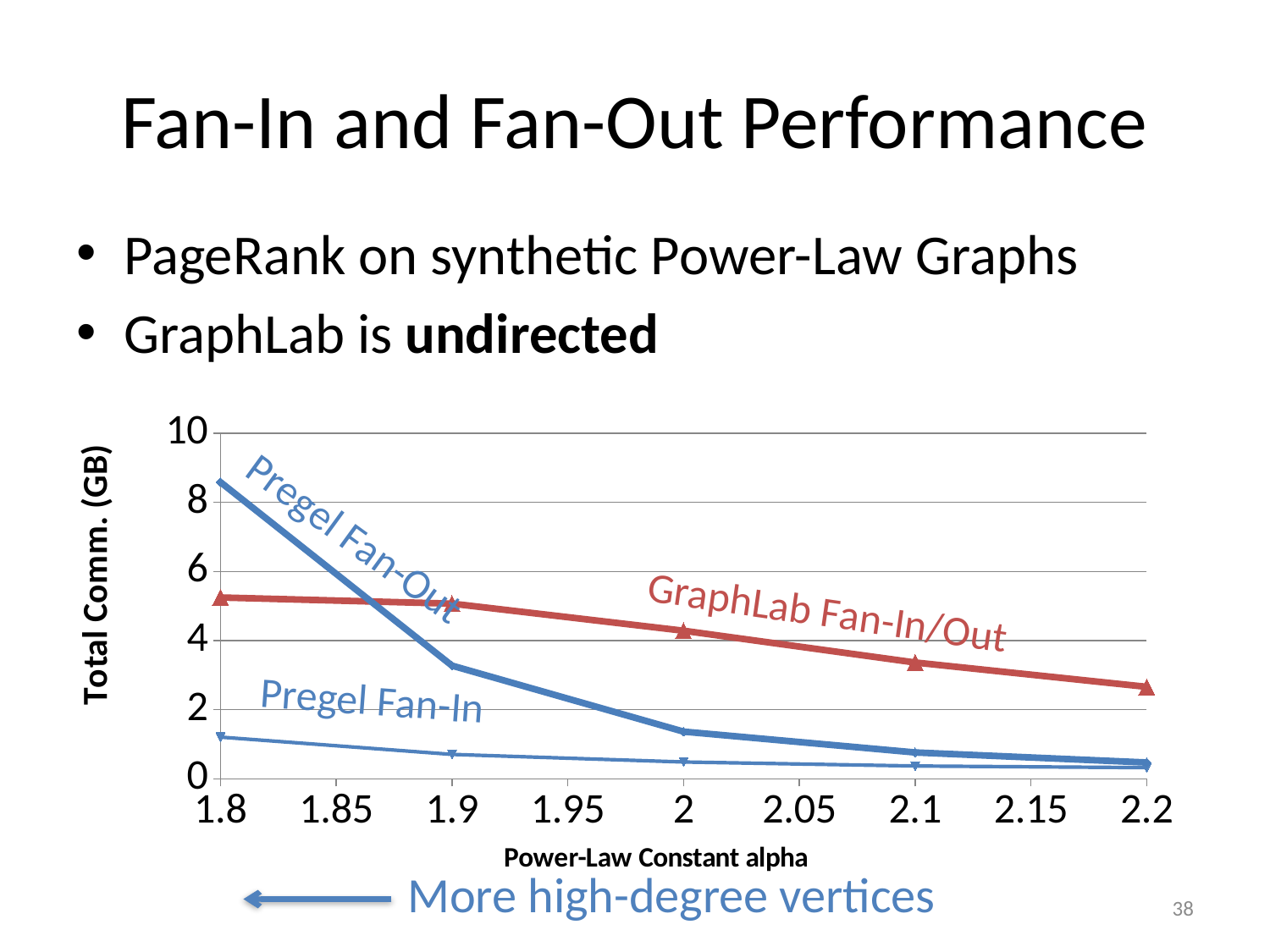
Which series has the highest value at alpha = 1.8? Pregel Fan-Out What kind of chart is shown on the slide? line chart Is the value for GraphLab Fan-In/Out at alpha = 1.8 greater or less than 6? less At alpha = 2, which is larger: GraphLab Fan-In/Out or Pregel Fan-Out? GraphLab Fan-In/Out What is the title of the x axis of the chart? Power-Law Constant alpha Which series has the lowest value at alpha = 1.8? Pregel Fan-In What is the title of the y axis of the chart? Total Comm. (GB) Does the Pregel Fan-Out series rise or fall as alpha increases from 1.8 to 2.2? fall How many series are plotted in the chart? 3 Is the value for GraphLab Fan-In/Out at alpha = 2.2 greater or less than 2? greater Is the value for Pregel Fan-Out at alpha = 1.8 greater or less than 8? greater